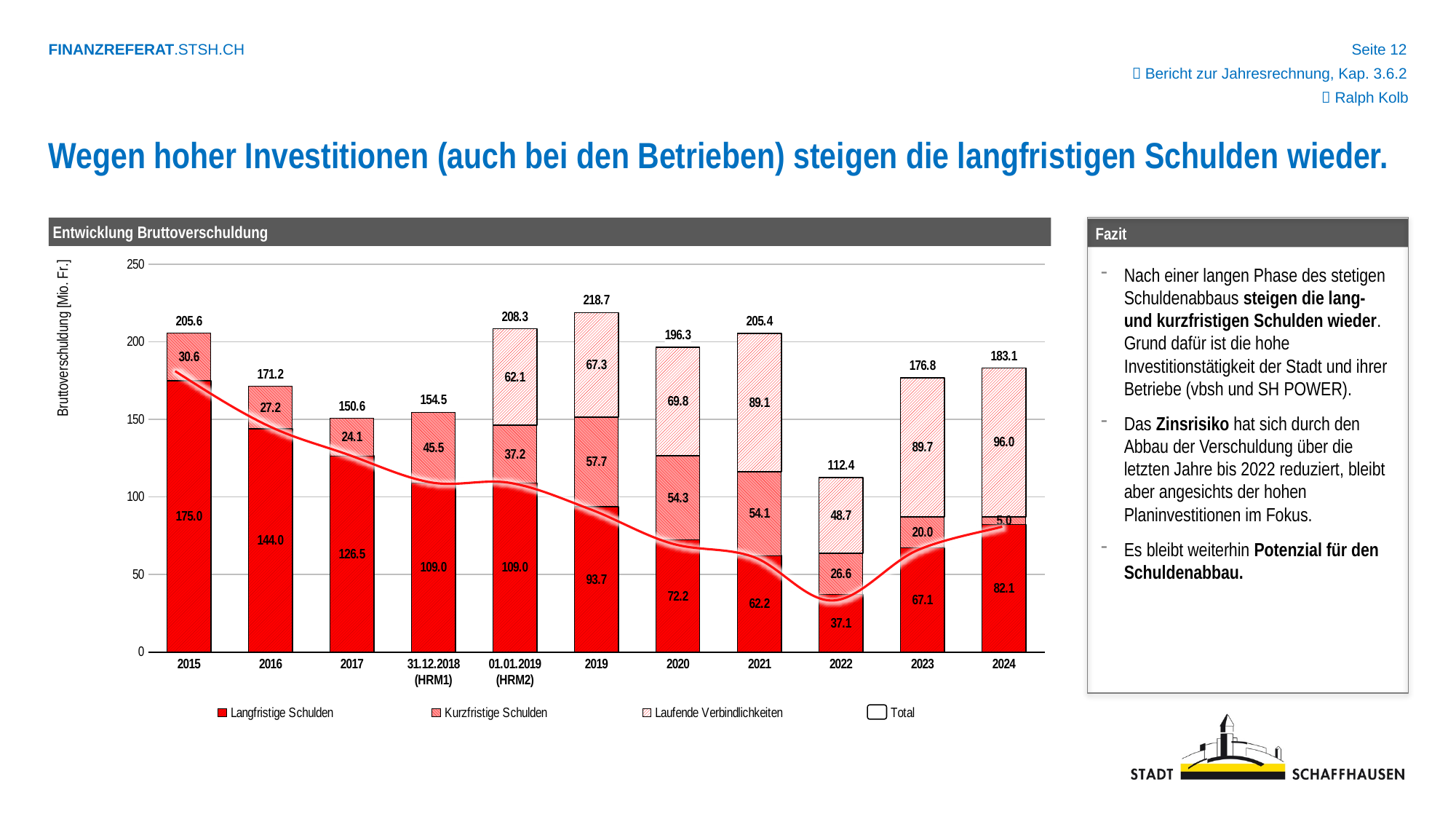
Which year has the highest total Bruttoverschuldung? 2019 How many entries does the legend list? 4 Do the Langfristige Schulden rise or fall from 2015 to 2022? fall What is the value of Laufende Verbindlichkeiten for 2024? 96.0 How many categories are shown on the x axis? 11 Which year has the lowest total Bruttoverschuldung? 2022 What is the total Bruttoverschuldung shown for 2019? 218.7 What is the value of Langfristige Schulden for 2015? 175.0 Which year has the lowest value of Langfristige Schulden? 2022 What is the difference between the Langfristige Schulden in 2015 and in 2024? 92.9 What is the value of Kurzfristige Schulden for 31.12.2018 (HRM1)? 45.5 Which is larger: the total for 2020 or the total for 2021? 2021